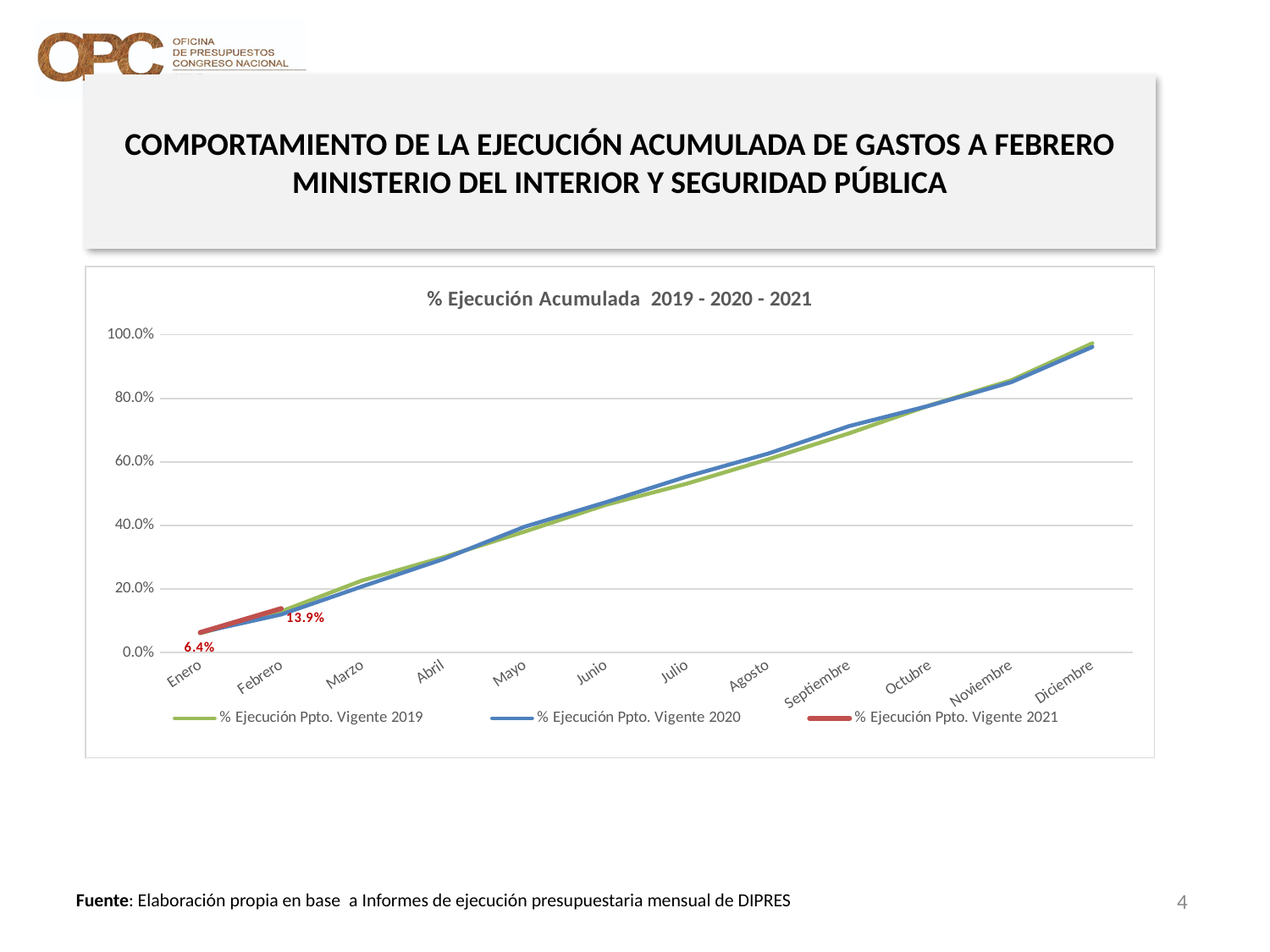
Do the values for % Ejecución Ppto. Vigente 2020 rise or fall from Enero to Diciembre? Rise Which series is drawn in red? % Ejecución Ppto. Vigente 2021 How many series does the legend list? 3 What is the value of % Ejecución Ppto. Vigente 2021 for Febrero? 13.9% How many months are shown on the x axis? 12 What kind of chart is shown on the slide? Line chart Is the value for % Ejecución Ppto. Vigente 2019 in Abril greater or less than 40.0%? less Is the value for % Ejecución Ppto. Vigente 2020 in Diciembre greater or less than 80.0%? greater What is the title of the chart? % Ejecución Acumulada 2019 - 2020 - 2021 What is the value of % Ejecución Ppto. Vigente 2021 for Enero? 6.4% Which is larger for % Ejecución Ppto. Vigente 2021: the value for Enero or the value for Febrero? Febrero By how much did % Ejecución Ppto. Vigente 2021 increase from Enero to Febrero? 7.5%